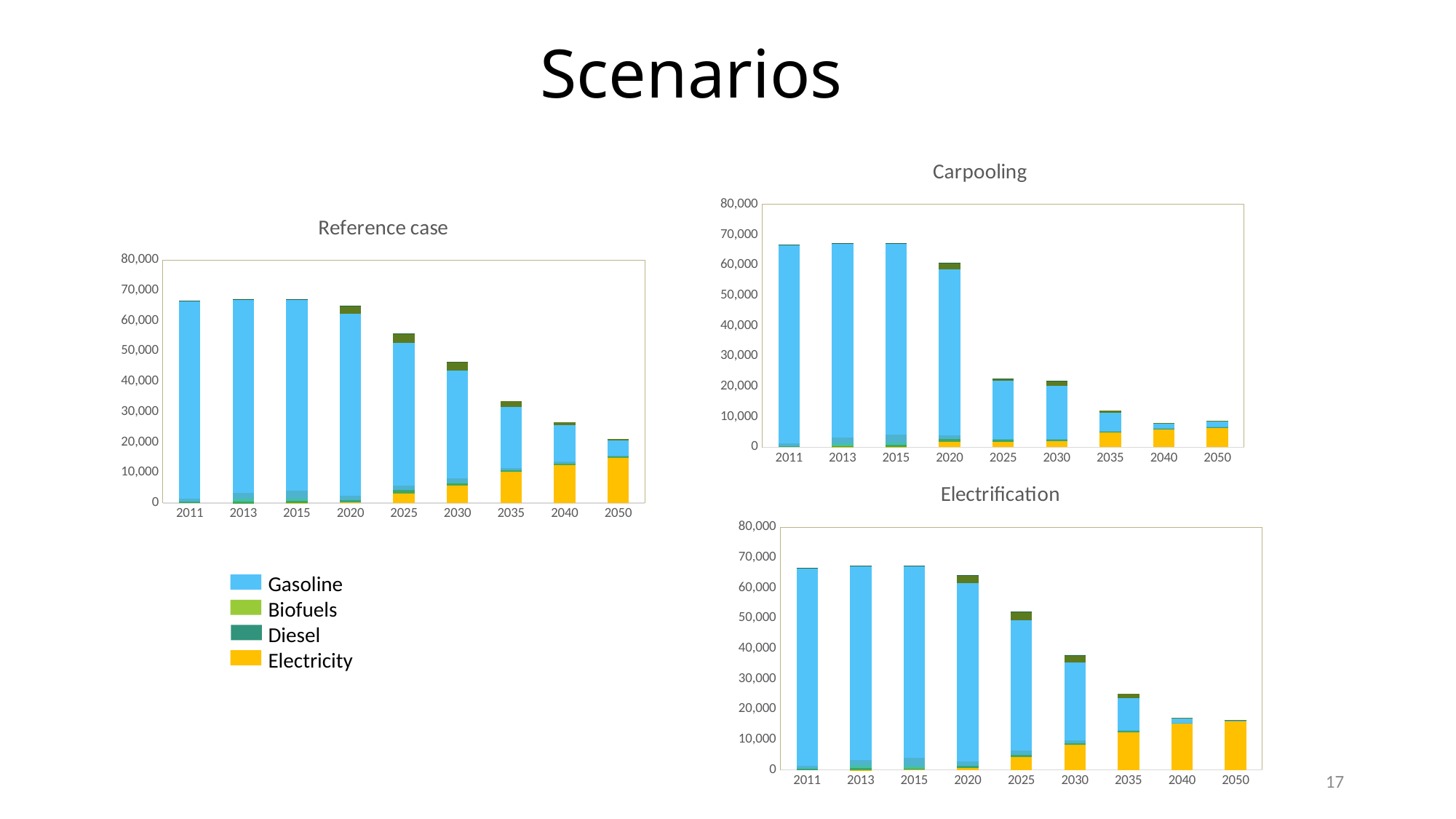
In the "Reference case" chart, which year has the lowest total bar? 2050 In the "Reference case" chart, which year has the larger total bar, 2030 or 2040? 2030 In the "Reference case" chart, is the total value for 2011 greater or less than 60,000? greater Do the total bar values in the "Electrification" chart generally rise or fall from 2011 to 2050? fall How many series does the legend list? 4 In the "Reference case" chart, is the total value for 2050 greater or less than 30,000? less In the "Carpooling" chart, is the total value for 2025 greater or less than 30,000? less How many year categories are shown on the x axis of the "Carpooling" chart? 9 What kind of chart is the "Reference case" chart? Stacked bar chart Which series in the legend is shown in yellow/orange? Electricity